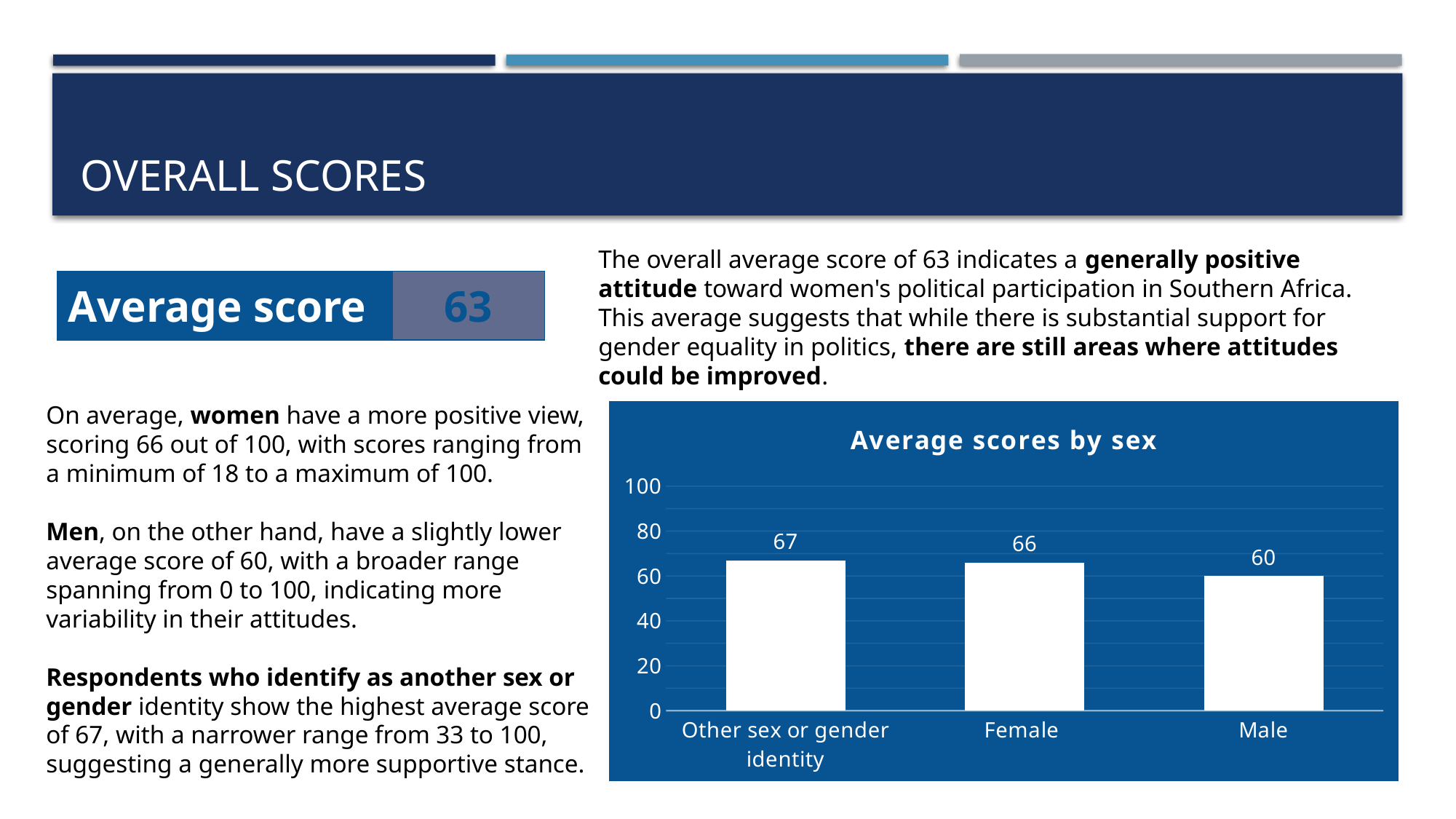
Which category has the lowest average score in the chart? Male What is the difference between the Female and Male average scores in the chart? 6 What type of chart is 'Average scores by sex'? bar chart How many categories are shown in the 'Average scores by sex' chart? 3 Which has a higher average score in the chart, Female or Male? Female What is the title of the chart on the slide? Average scores by sex Which category has the highest average score in the chart? Other sex or gender identity What is the average score for Male in the 'Average scores by sex' chart? 60 Is the value for Male greater or less than 80? less What is the average score for 'Other sex or gender identity' in the chart? 67 What is the average score for Female in the 'Average scores by sex' chart? 66 What is the difference between the 'Other sex or gender identity' and Male average scores? 7